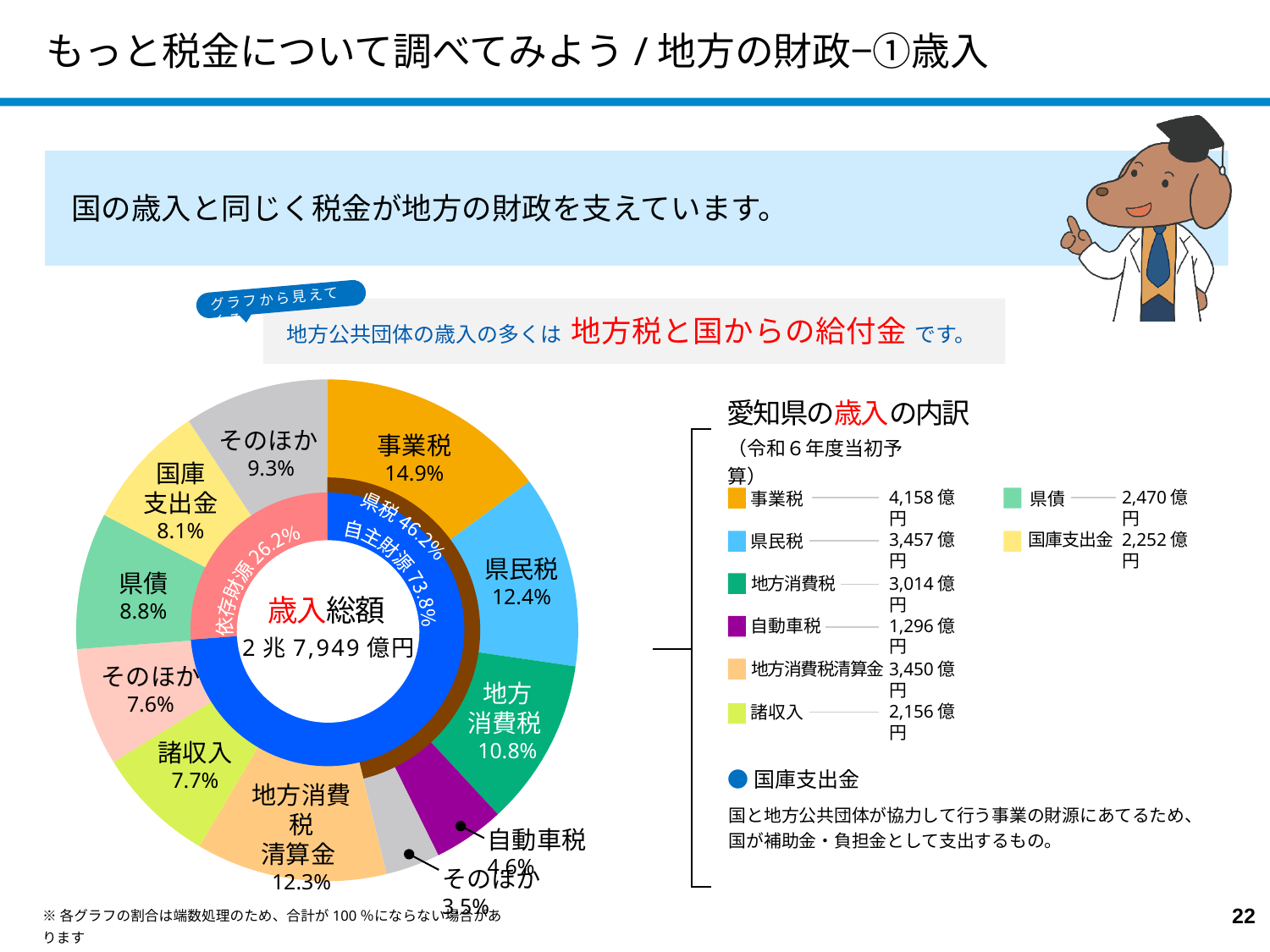
What is the difference in percentage points between 事業税 (14.9%) and 県民税 (12.4%)? 2.5 What percentage share does 事業税 have in the 歳入 chart? 14.9% What percentage share does 県民税 have in the chart? 12.4% What share of the total is 依存財源 according to the inner ring? 26.2% According to the legend, what is the amount for 自動車税? 1,296億円 What type of chart is shown on the slide? Pie (donut) chart Which has a larger share, 県債 or 国庫支出金? 県債 What is the share of 県税 shown in the inner ring? 46.2% What is the 歳入総額 shown in the centre of the chart? 2兆7,949億円 What share of the total is 自主財源 according to the inner ring? 73.8% Which named tax category has the largest share in the chart? 事業税 According to the legend, what is the amount for 国庫支出金? 2,252億円